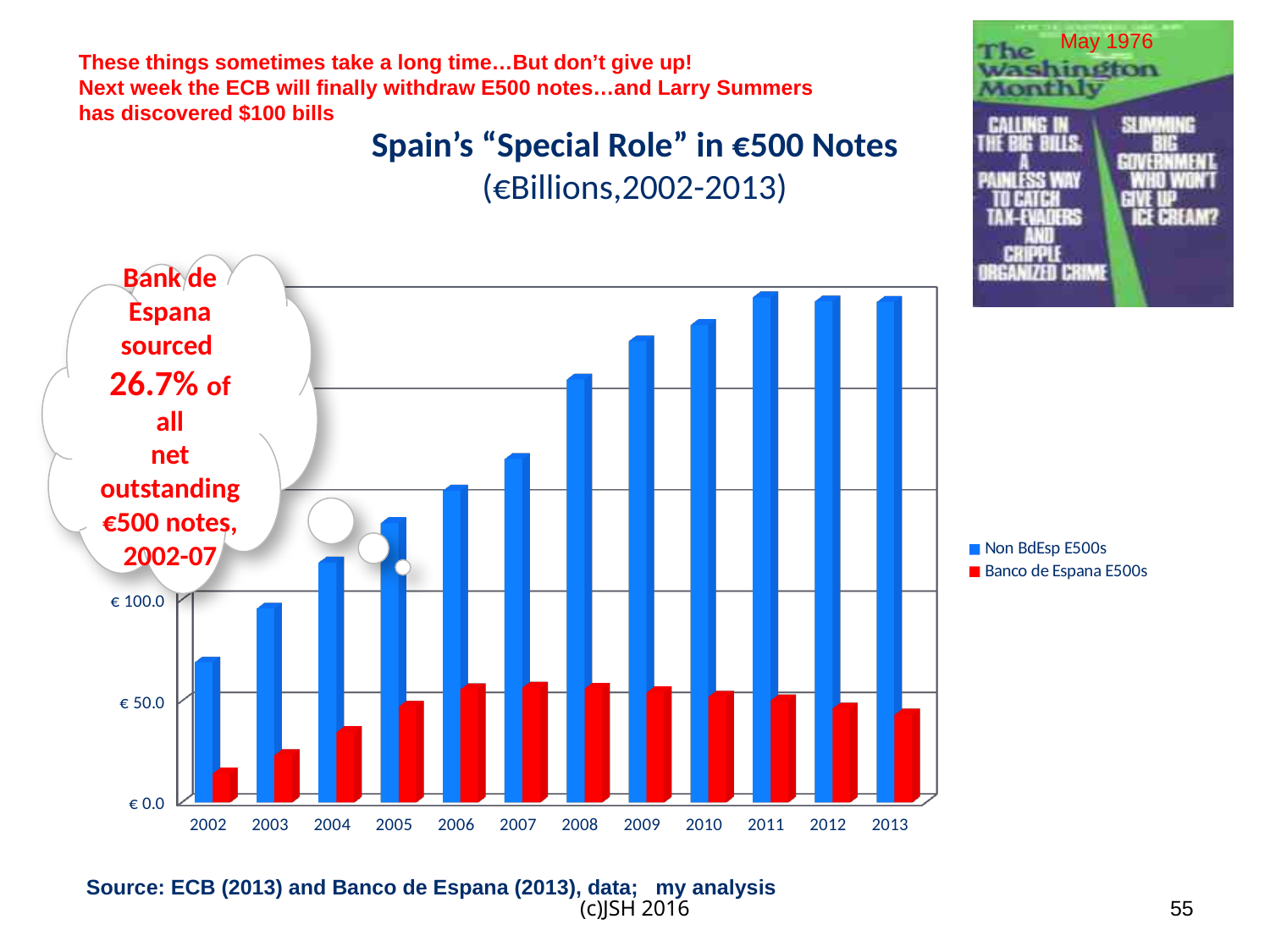
Do the values for Non BdEsp E500s generally rise or fall from 2002 to 2013? rise Which year has the lowest value for Non BdEsp E500s? 2002 What kind of chart is shown on the slide? bar chart Which is larger in 2010: Non BdEsp E500s or Banco de Espana E500s? Non BdEsp E500s How many years are shown on the x axis of the chart? 12 Which is larger for Banco de Espana E500s: the value in 2002 or the value in 2007? 2007 Is the value for Non BdEsp E500s in 2002 greater or less than € 50.0? greater How many series does the chart's legend list? 2 Is the value for Banco de Espana E500s in 2004 greater or less than € 50.0? less Which year has the lowest value for Banco de Espana E500s? 2002 Which colour represents Banco de Espana E500s in the chart? red Is the value for Non BdEsp E500s in 2004 greater or less than € 100.0? greater